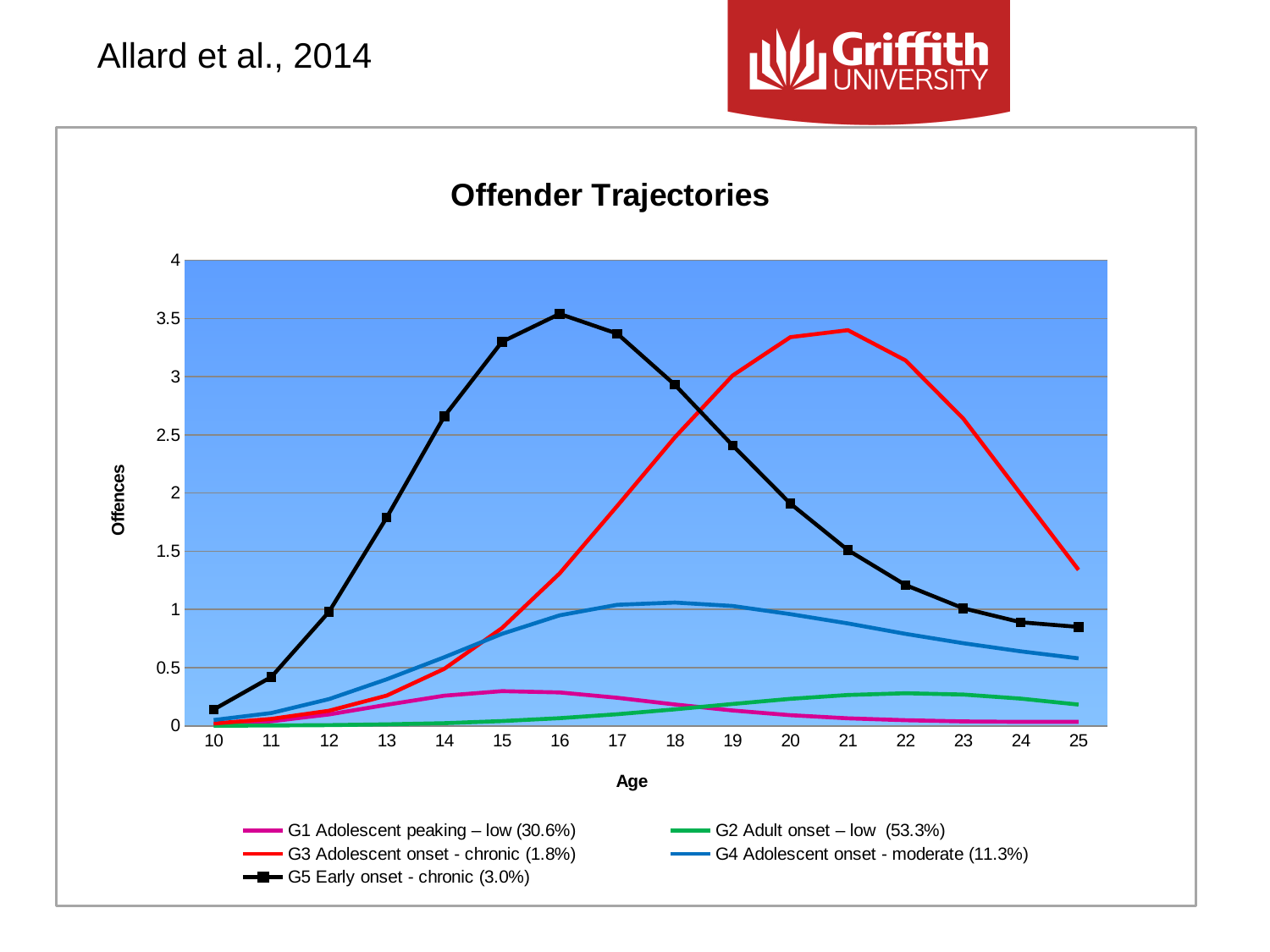
Do the values for G5 Early onset - chronic rise or fall from age 16 to age 25? fall How many age points are shown along the x axis of the Offender Trajectories chart? 16 At age 22, which series has the larger value: G3 Adolescent onset - chronic or G5 Early onset - chronic? G3 Adolescent onset - chronic Which series has the lowest value at age 25? G1 Adolescent peaking – low What kind of chart is shown on the slide? line chart What percentage is shown in the legend for G2 Adult onset – low? 53.3% How many series does the legend of the Offender Trajectories chart list? 5 Is the value for G1 Adolescent peaking – low at age 15 greater or less than 0.5? less Is the value for G4 Adolescent onset - moderate at age 18 greater or less than 1.5? less At age 16, which series has the larger value: G5 Early onset - chronic or G3 Adolescent onset - chronic? G5 Early onset - chronic Is the value for G3 Adolescent onset - chronic at age 21 greater or less than 3? greater